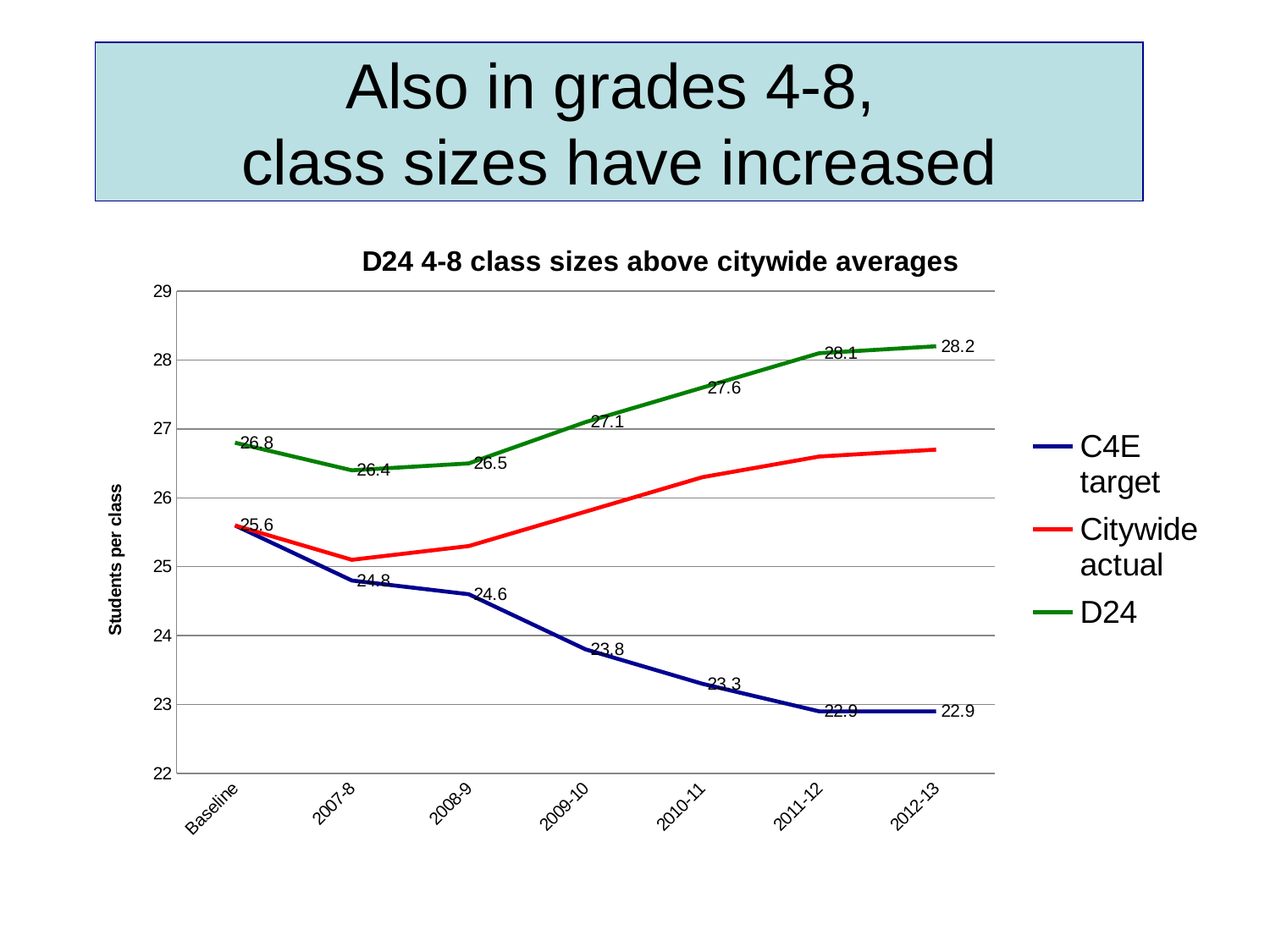
How many series does the legend list? 3 In which year is the C4E target value highest? Baseline Does the D24 series rise or fall from 2008-9 to 2012-13? rise What is the title of the chart? D24 4-8 class sizes above citywide averages What is the difference between the D24 value and the C4E target value in 2011-12? 5.2 Is the Citywide actual value for 2012-13 greater or less than 26? greater How many points are plotted along the x axis for each series? 7 In which year is the D24 value highest? 2012-13 What type of chart is shown on the slide? line chart What is the C4E target value for 2009-10? 23.8 What is the D24 value for 2007-8? 26.4 What is the D24 value for 2012-13? 28.2